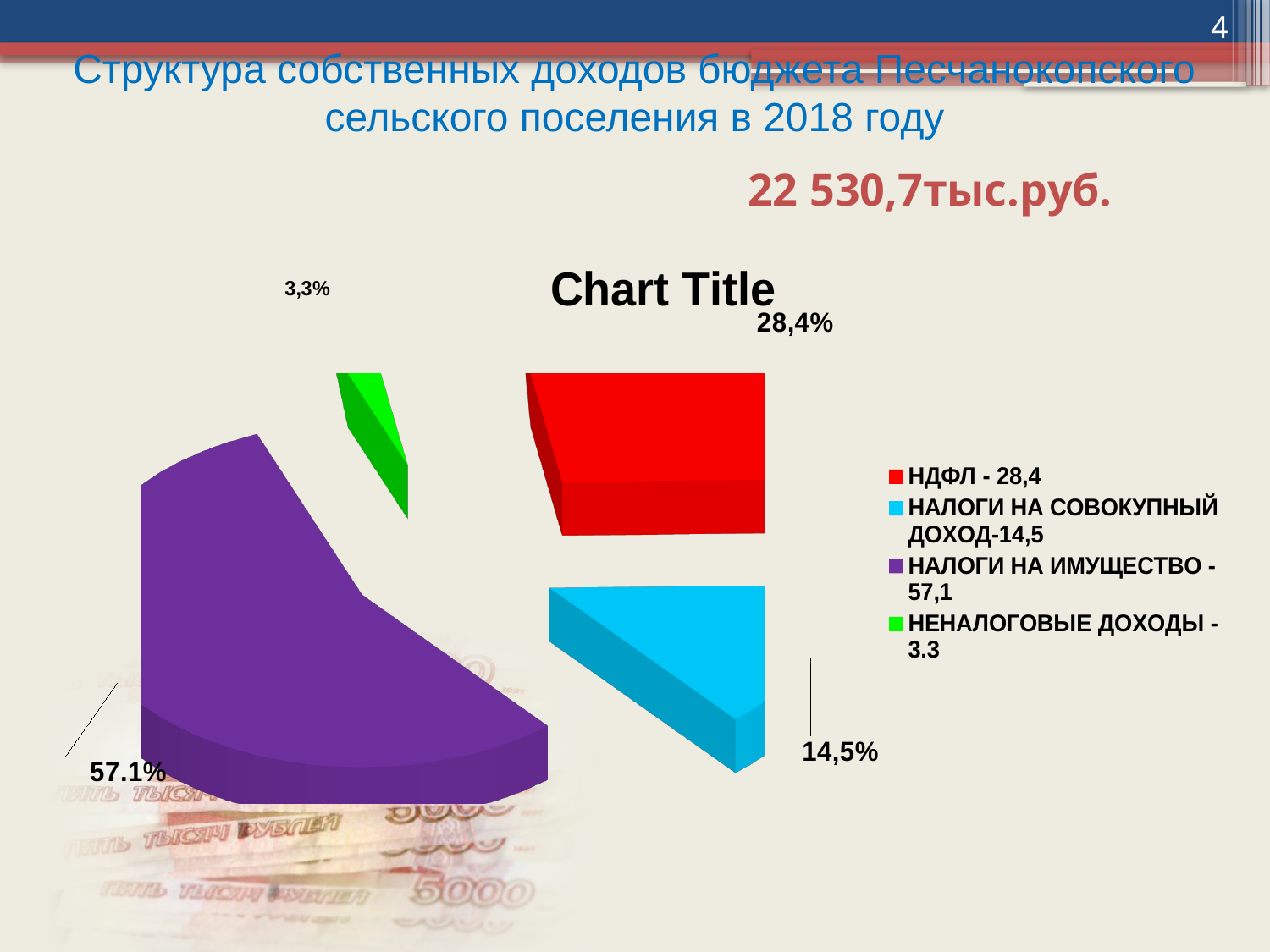
What is the share for НАЛОГИ НА СОВОКУПНЫЙ ДОХОД? 14,5% How many slices does the pie chart have? 4 What is the title printed above the pie chart? Chart Title What colour is the slice for НДФЛ? red What is the share for НДФЛ? 28,4% What is the share for НАЛОГИ НА ИМУЩЕСТВО? 57.1% What is the difference in percentage points between the НДФЛ share and the НАЛОГИ НА СОВОКУПНЫЙ ДОХОД share? 13,9 Which category has the smallest slice of the pie? НЕНАЛОГОВЫЕ ДОХОДЫ What is the share for НЕНАЛОГОВЫЕ ДОХОДЫ? 3,3% Which category has the largest slice of the pie? НАЛОГИ НА ИМУЩЕСТВО What kind of chart is shown on the slide? pie chart Which is larger, the share for НДФЛ or the share for НАЛОГИ НА СОВОКУПНЫЙ ДОХОД? НДФЛ